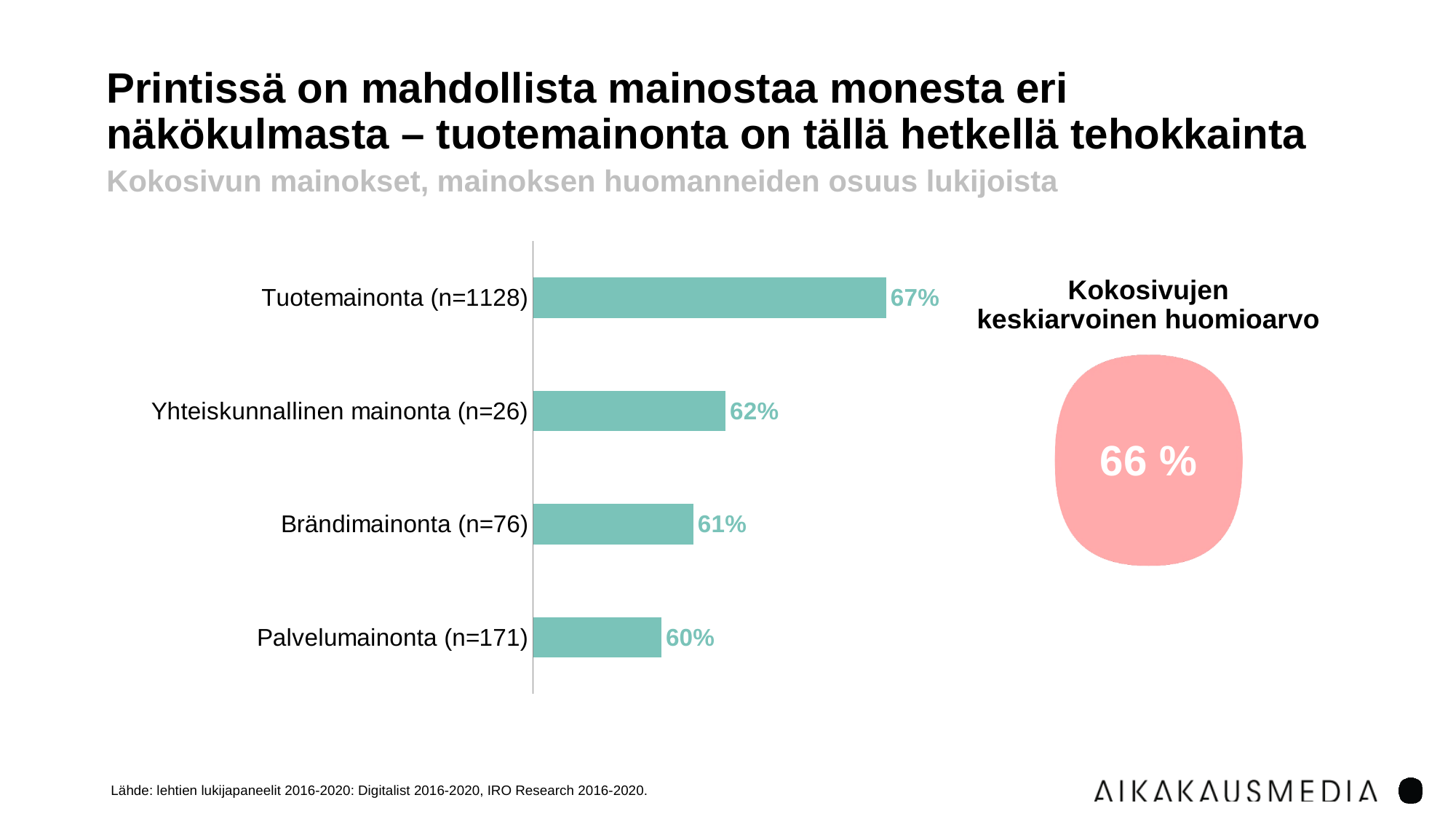
Which is larger, the value for Yhteiskunnallinen mainonta (n=26) or Brändimainonta (n=76)? Yhteiskunnallinen mainonta (n=26) What is the difference between the values for Tuotemainonta (n=1128) and Palvelumainonta (n=171)? 7 percentage points What is the value for Palvelumainonta (n=171)? 60% Which category has the lowest value? Palvelumainonta (n=171) What is the difference between the values for Yhteiskunnallinen mainonta (n=26) and Brändimainonta (n=76)? 1 percentage point What is the value for Brändimainonta (n=76)? 61% What kind of chart is shown on the slide? Bar chart What is the value for Yhteiskunnallinen mainonta (n=26)? 62% Which category has the highest value? Tuotemainonta (n=1128) What is the average attention value (Kokosivujen keskiarvoinen huomioarvo) shown in the pink circle? 66 % How many categories are shown in the bar chart? 4 What is the value for Tuotemainonta (n=1128)? 67%